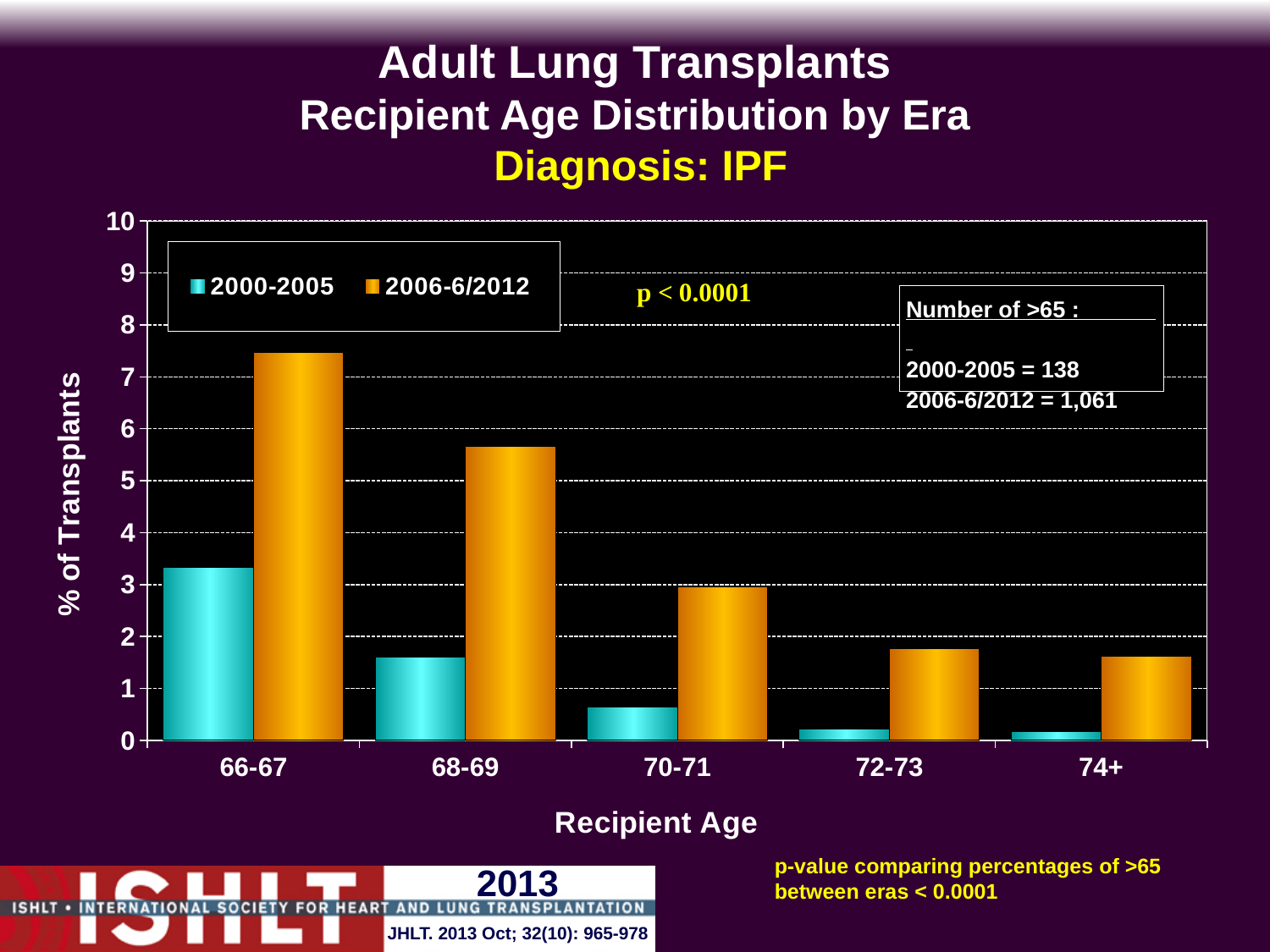
How many series does the legend list? 2 Do the values for the 2006-6/2012 series rise or fall as recipient age increases along the x axis? fall Which recipient age category has the highest value for the 2000-2005 series? 66-67 What kind of chart is shown on the slide? bar chart According to the text box on the chart, what is the number of recipients >65 for 2006-6/2012? 1,061 Is the value for the 2000-2005 series at age 70-71 greater or less than 1? less How many recipient age categories are shown on the x axis? 5 Is the value for the 2006-6/2012 series at age 66-67 greater or less than 7? greater For the 66-67 age group, which era has the larger percentage of transplants, 2000-2005 or 2006-6/2012? 2006-6/2012 Which recipient age category has the highest value for the 2006-6/2012 series? 66-67 What is the p-value shown on the chart? p < 0.0001 Is the value for the 2006-6/2012 series at age 68-69 greater or less than 5? greater